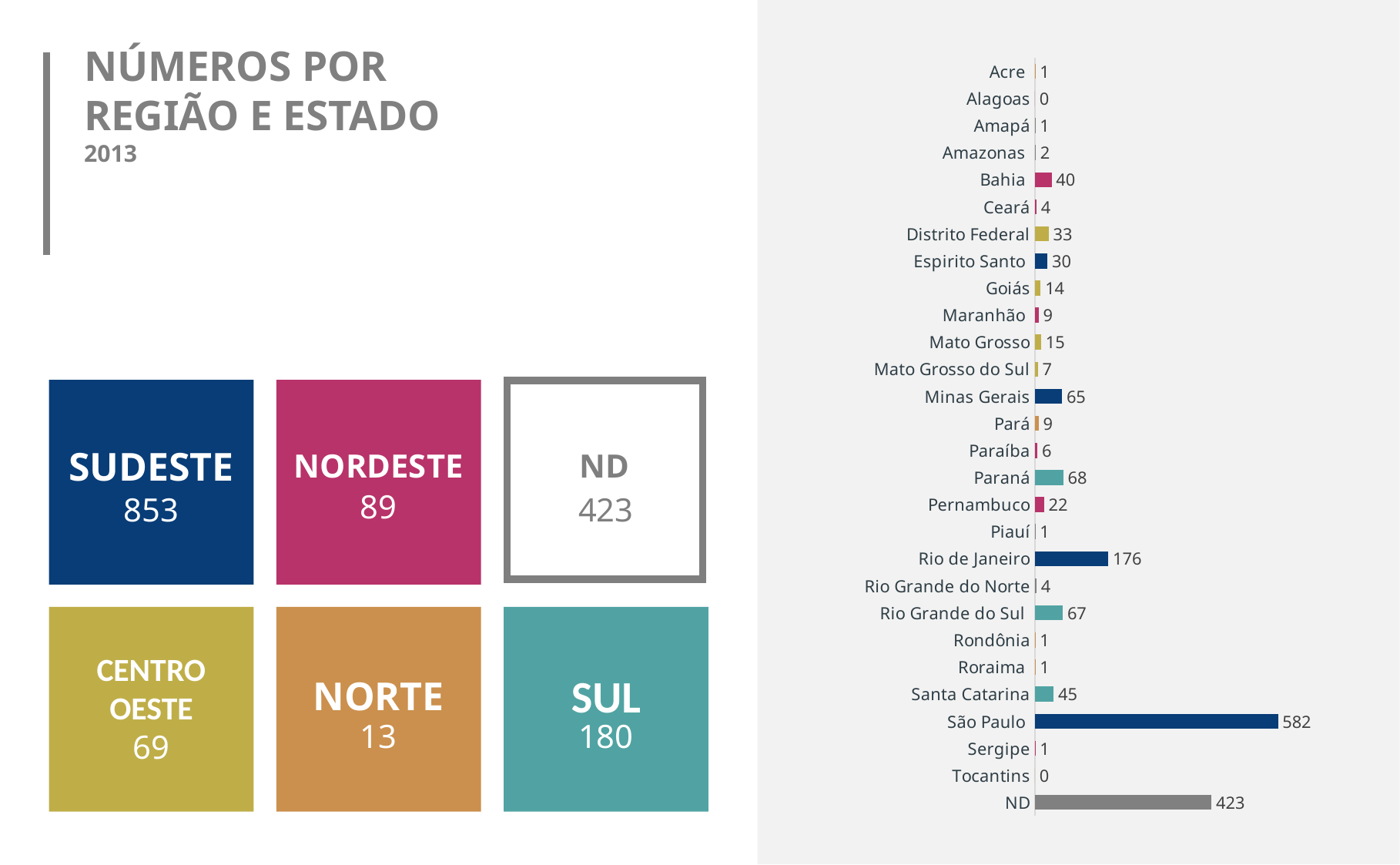
Which has a larger value in the bar chart, Bahia or Santa Catarina? Santa Catarina How many categories are shown in the bar chart? 28 What type of chart is shown on the right side of the slide? Bar chart What is the value for Paraná in the bar chart? 68 What is the value for São Paulo in the bar chart? 582 Which two categories in the bar chart have a value of 0? Alagoas and Tocantins Which state has the highest value in the bar chart? São Paulo What is the value for Distrito Federal in the bar chart? 33 What is the value for Rio de Janeiro in the bar chart? 176 What is the difference between the values for São Paulo and Rio de Janeiro in the bar chart? 406 What is the difference between the values for Paraná and Rio Grande do Sul in the bar chart? 1 Which has a larger value in the bar chart, Minas Gerais or Espirito Santo? Minas Gerais